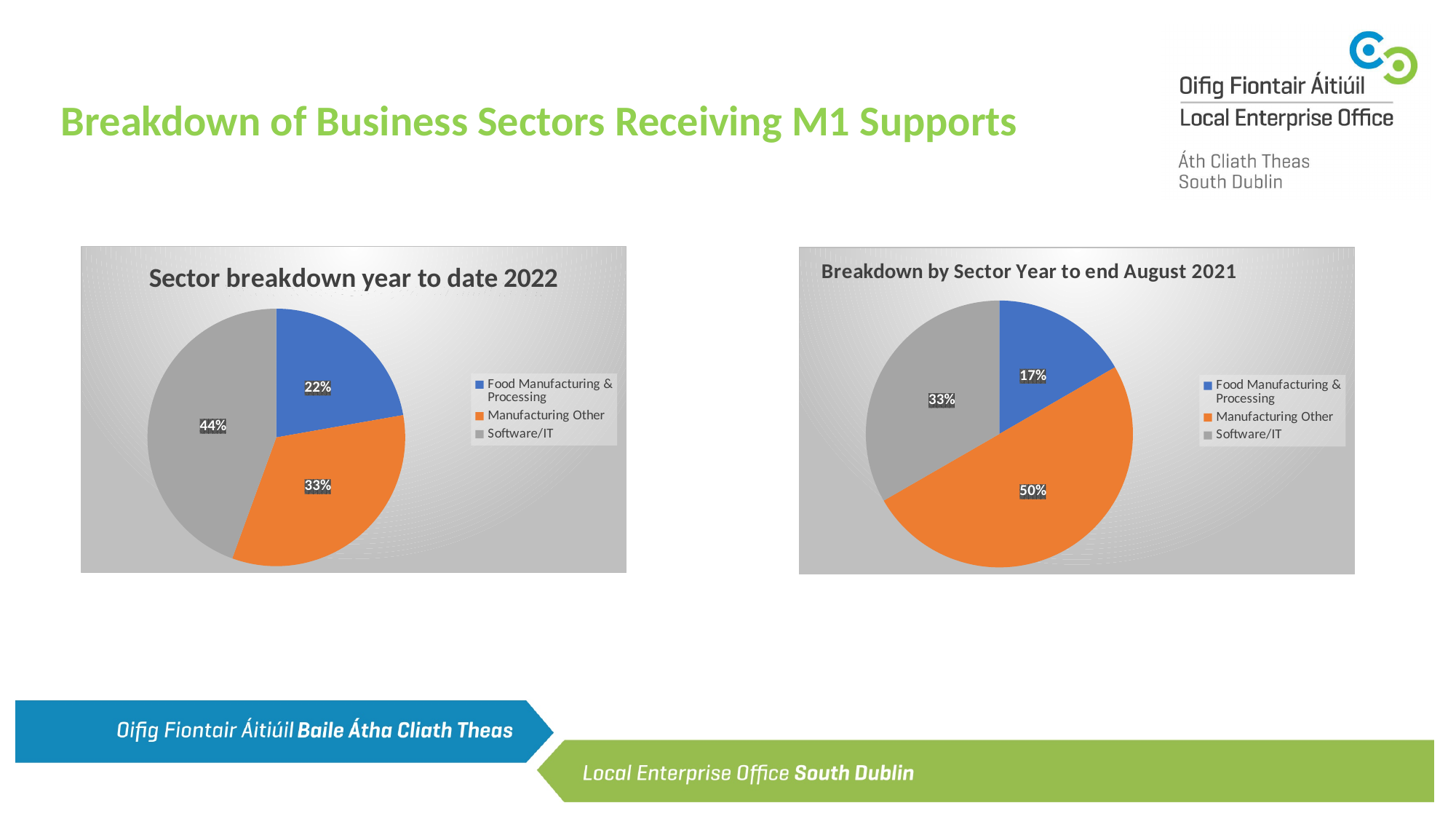
In the 'Breakdown by Sector Year to end August 2021' chart, which sector has the smallest share? Food Manufacturing & Processing In the 'Breakdown by Sector Year to end August 2021' chart, what share does Manufacturing Other have? 50% How many sectors does the legend of the 'Breakdown by Sector Year to end August 2021' chart list? 3 What type of chart is the 'Sector breakdown year to date 2022' chart? Pie chart In the 'Sector breakdown year to date 2022' chart, what is the difference between the Software/IT share and the Manufacturing Other share? 11% In the 'Sector breakdown year to date 2022' chart, what share does Software/IT have? 44% In the 'Sector breakdown year to date 2022' chart, what share does Food Manufacturing & Processing have? 22% In the 'Breakdown by Sector Year to end August 2021' chart, what share does Food Manufacturing & Processing have? 17% In the 'Breakdown by Sector Year to end August 2021' chart, what is the difference between the Manufacturing Other share and the Software/IT share? 17% In the 'Sector breakdown year to date 2022' chart, which sector has the largest share? Software/IT In the 'Breakdown by Sector Year to end August 2021' chart, which sector has the largest share? Manufacturing Other In the 'Sector breakdown year to date 2022' chart, which is larger: the Manufacturing Other share or the Food Manufacturing & Processing share? Manufacturing Other